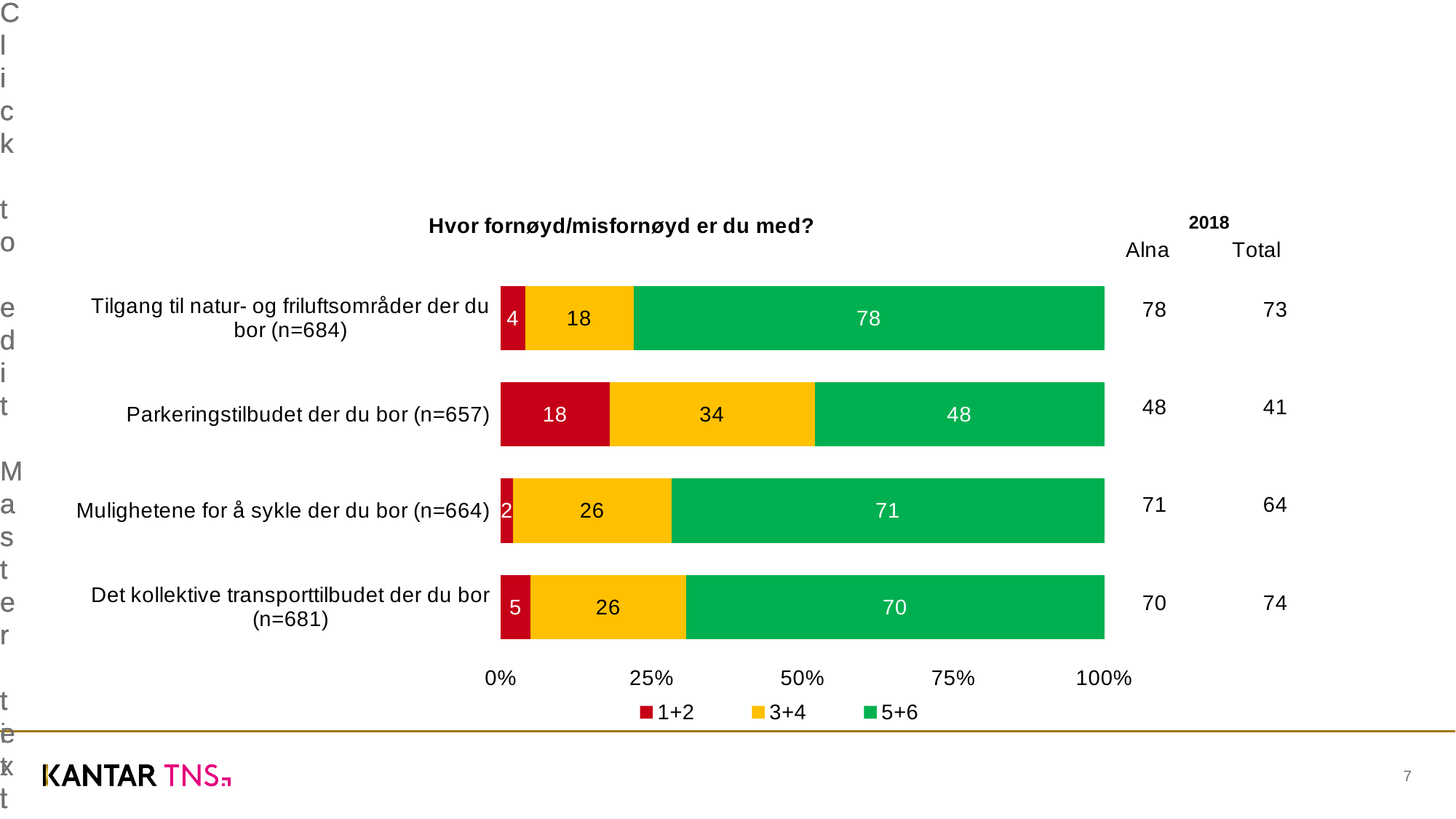
What is the difference between the 5+6 value for "Tilgang til natur- og friluftsområder der du bor" and the 5+6 value for "Parkeringstilbudet der du bor"? 30 How many series does the legend list? 3 What is the value of the 3+4 segment for "Mulighetene for å sykle der du bor (n=664)"? 26 What is the title of the chart? Hvor fornøyd/misfornøyd er du med? Which has the larger 3+4 value: "Parkeringstilbudet der du bor" or "Tilgang til natur- og friluftsområder der du bor"? Parkeringstilbudet der du bor Which category has the highest 5+6 value? Tilgang til natur- og friluftsområder der du bor (n=684) What is the value of the 1+2 segment for "Tilgang til natur- og friluftsområder der du bor (n=684)"? 4 Which category has the lowest 1+2 value? Mulighetene for å sykle der du bor (n=664) How many categories are shown in the chart? 4 What kind of chart is shown on the slide? Stacked bar chart What is the value of the 5+6 segment for "Parkeringstilbudet der du bor (n=657)"? 48 What is the total of the stacked bar for "Parkeringstilbudet der du bor (n=657)"? 100